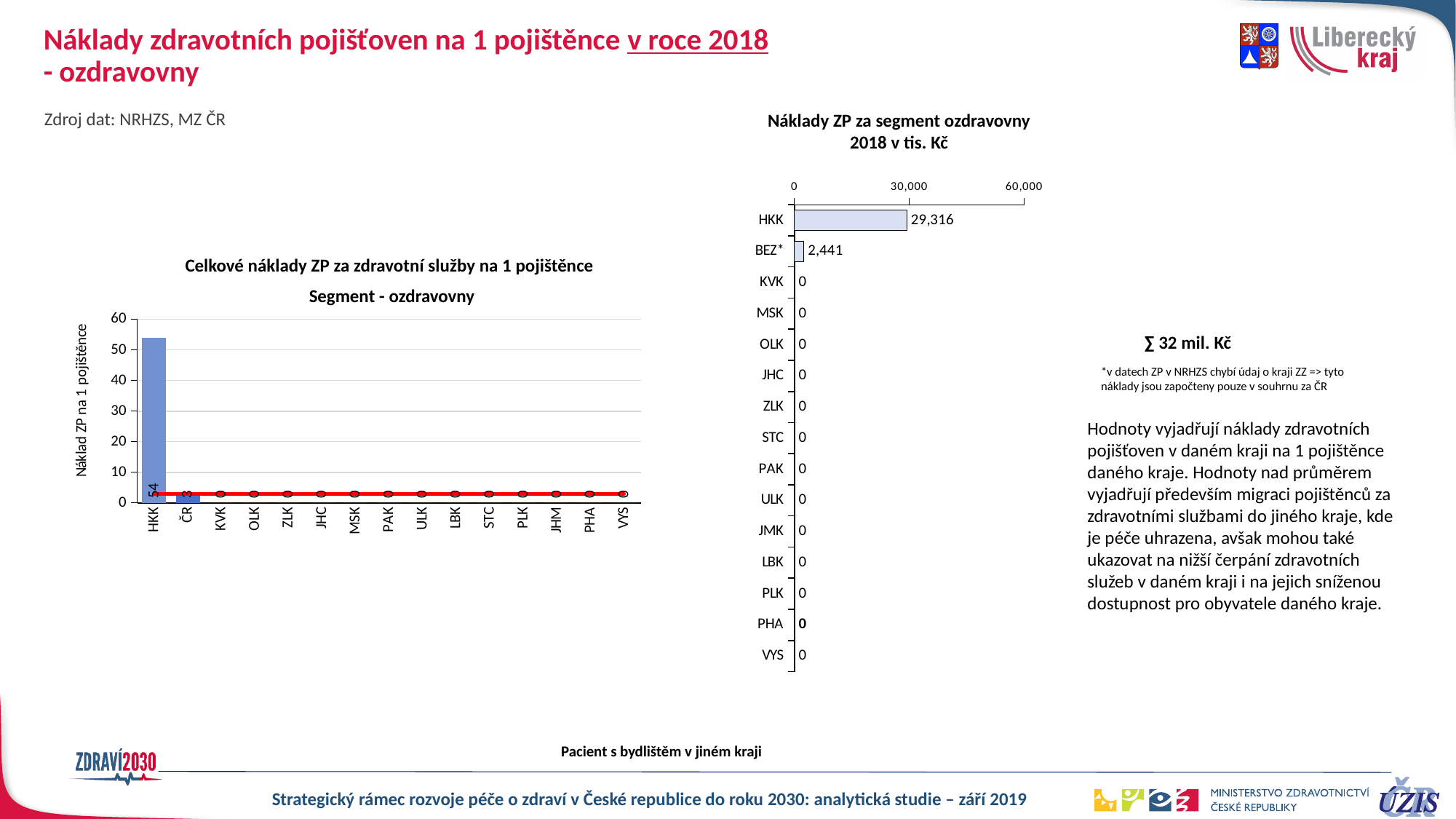
In the chart titled 'Náklady ZP za segment ozdravovny 2018 v tis. Kč', what is the difference between the values for HKK and BEZ*? 26,875 In the chart titled 'Celkové náklady ZP za zdravotní služby na 1 pojištěnce', is the value for HKK greater or less than 50? greater In the chart titled 'Náklady ZP za segment ozdravovny 2018 v tis. Kč', what is the value for BEZ*? 2,441 In the chart titled 'Náklady ZP za segment ozdravovny 2018 v tis. Kč', is the value for HKK greater or less than 30,000? less In the chart titled 'Náklady ZP za segment ozdravovny 2018 v tis. Kč', how many categories are shown? 15 In the chart titled 'Náklady ZP za segment ozdravovny 2018 v tis. Kč', what is the value for KVK? 0 In the chart titled 'Celkové náklady ZP za zdravotní služby na 1 pojištěnce', what is the value for HKK? 54 In the chart titled 'Celkové náklady ZP za zdravotní služby na 1 pojištěnce', which category has the highest value? HKK In the chart titled 'Náklady ZP za segment ozdravovny 2018 v tis. Kč', what is the value for HKK? 29,316 What kind of chart is the chart titled 'Celkové náklady ZP za zdravotní služby na 1 pojištěnce'? combination bar and line chart In the chart titled 'Náklady ZP za segment ozdravovny 2018 v tis. Kč', which is larger, the value for HKK or the value for BEZ*? HKK In the chart titled 'Náklady ZP za segment ozdravovny 2018 v tis. Kč', which category has the highest value? HKK